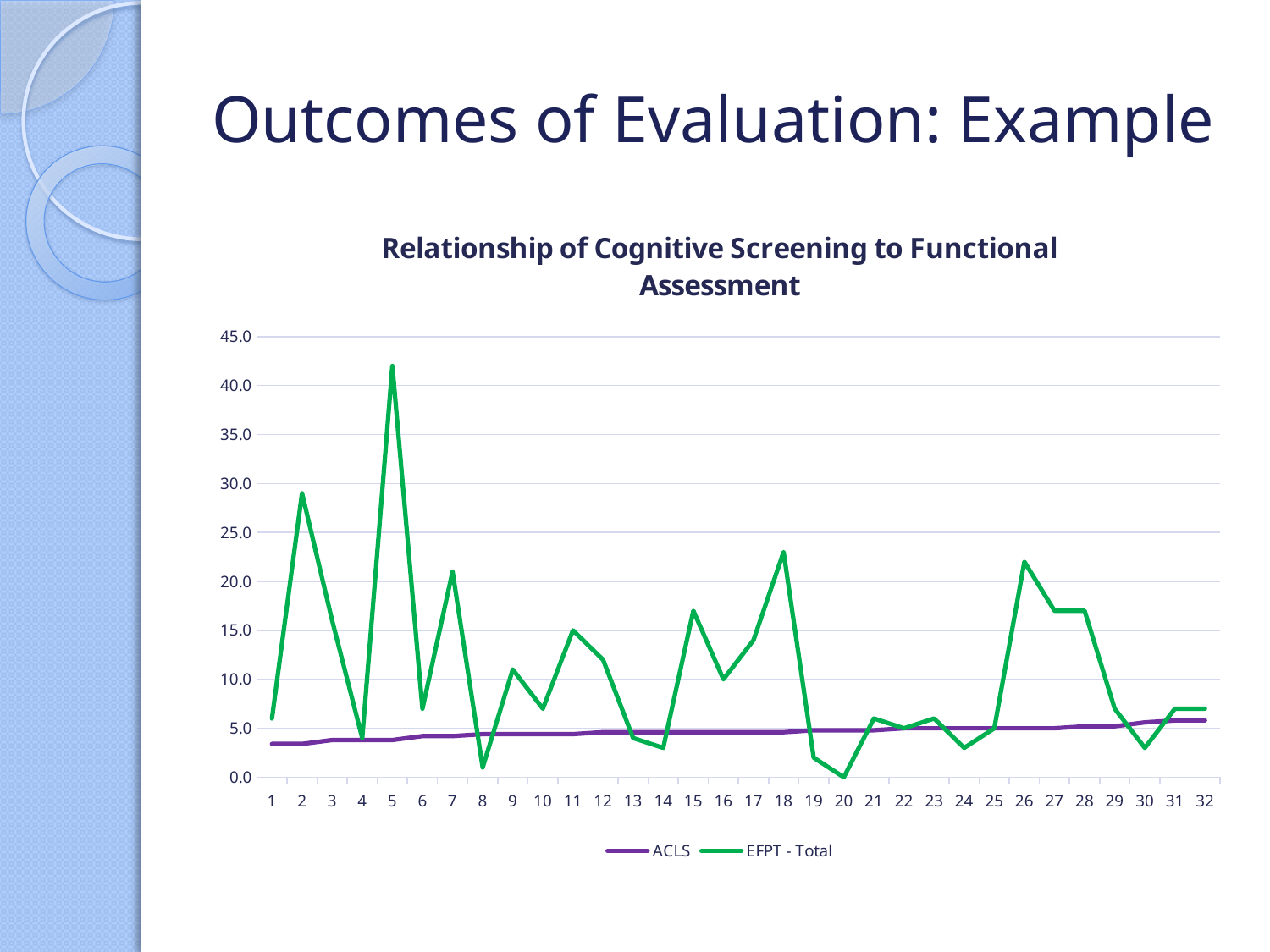
Which is larger, the EFPT - Total value at point 2 or at point 5? point 5 Is the ACLS value at point 1 greater or less than 5.0? less What is the title of the chart? Relationship of Cognitive Screening to Functional Assessment At which x-axis point does the EFPT - Total series reach its lowest value? 20 Does the ACLS series generally rise or fall from point 1 to point 32? rise At which x-axis point does the EFPT - Total series reach its highest value? 5 How many points are plotted along the x axis for each series? 32 Is the EFPT - Total value at point 18 greater or less than 20.0? greater How many series does the legend list? 2 Is the EFPT - Total value at point 20 greater or less than 5.0? less What kind of chart is shown on the slide? line chart